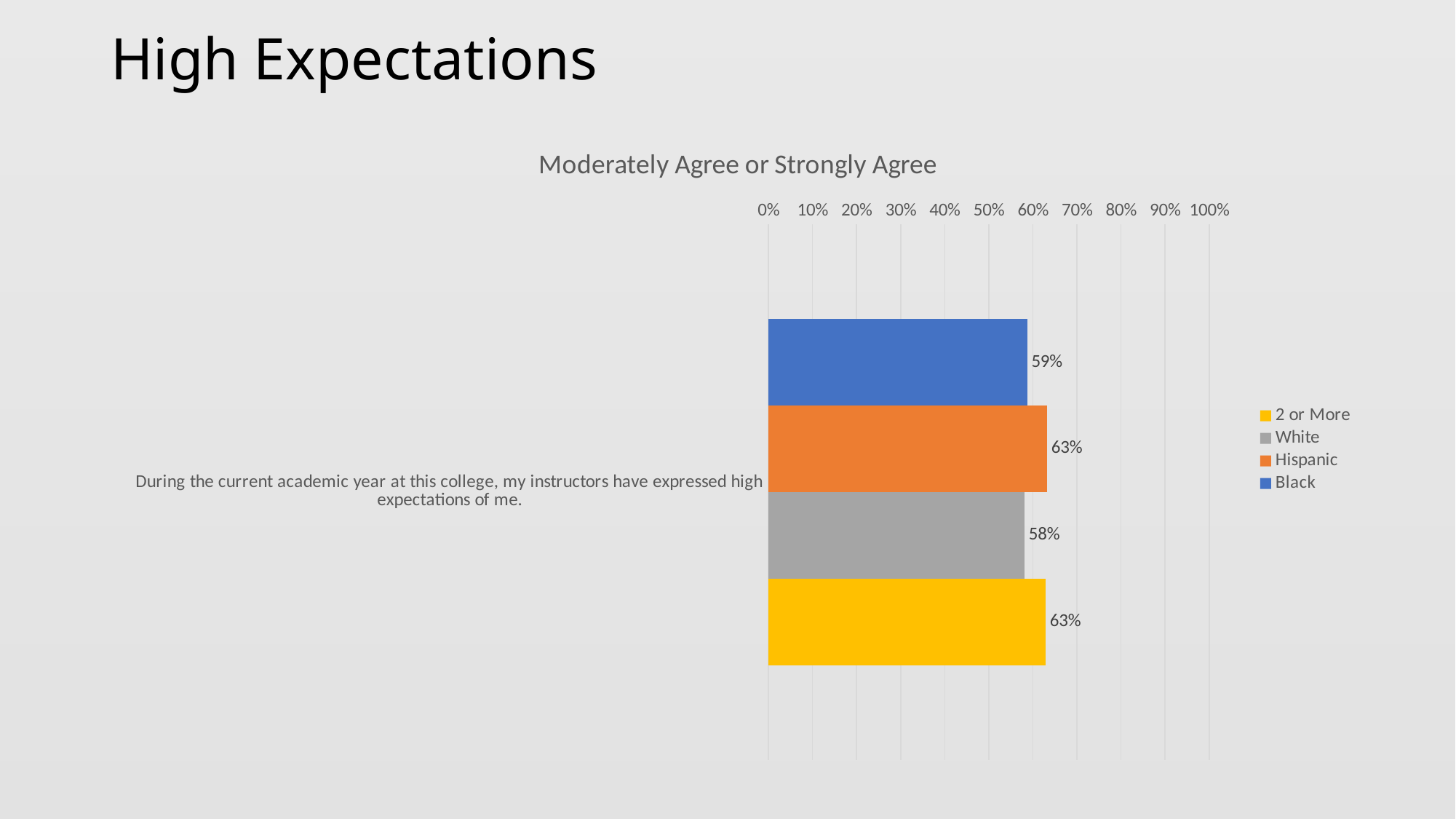
What is the difference between the values for Hispanic and White? 5% What is the value for 2 or More? 63% What is the title of the chart? Moderately Agree or Strongly Agree What is the difference between the values for Black and White? 1% Is the value for 2 or More greater or less than 50%? greater Which group has the lowest value? White How many series does the legend list? 4 What is the value for White? 58% What is the value for Hispanic? 63% Which is larger, the value for Hispanic or the value for Black? Hispanic What kind of chart is shown on the slide? bar chart What is the value for Black? 59%